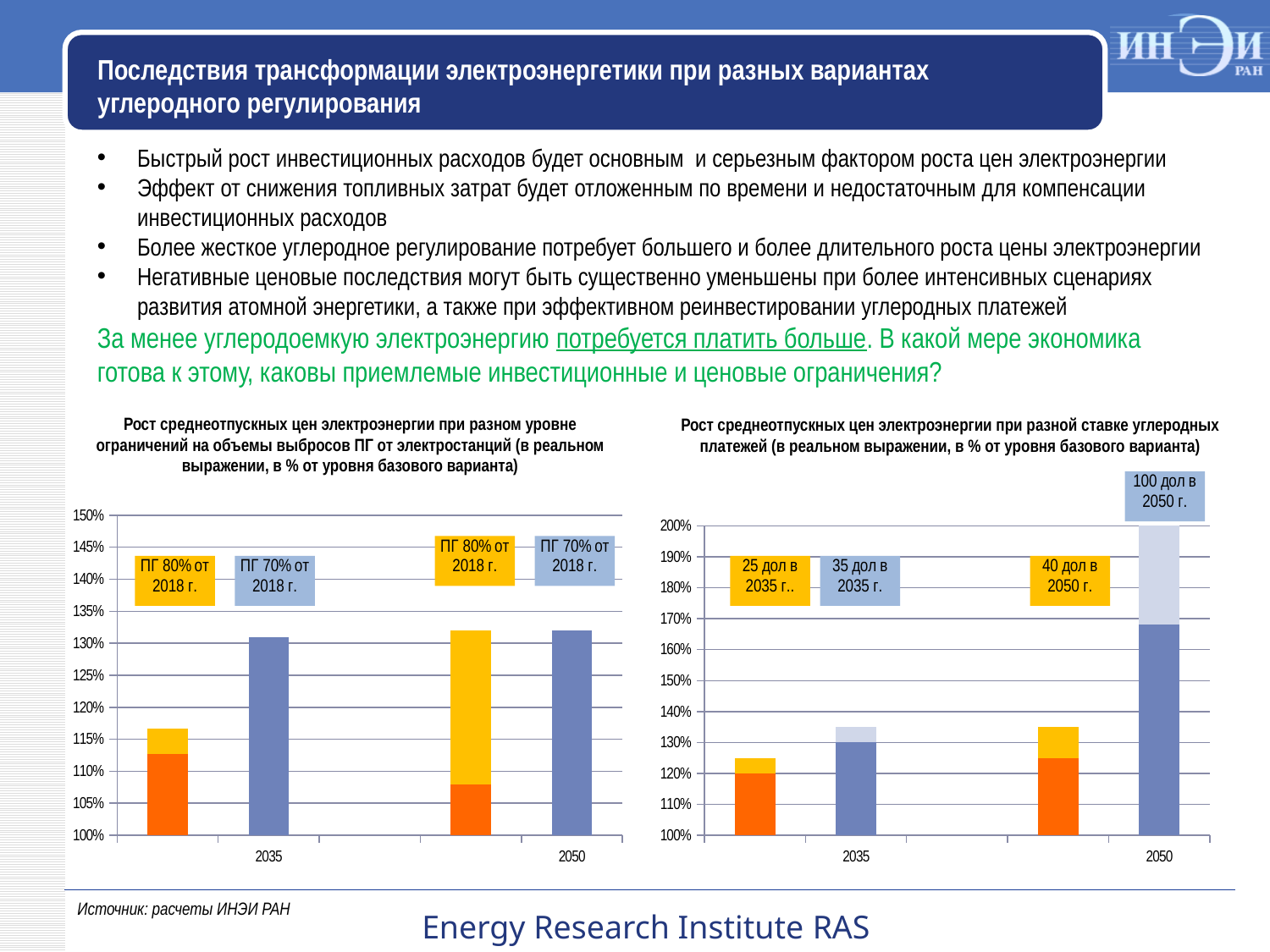
In the left chart, which bar is higher in 2035: 'ПГ 80% от 2018 г.' or 'ПГ 70% от 2018 г.'? ПГ 70% от 2018 г. In the right chart, is the value for the '25 дол в 2035 г.' bar greater or less than 130%? less What is the lowest value shown on the y axis of the left chart? 100% In the left chart, does the 'ПГ 80% от 2018 г.' bar rise or fall from 2035 to 2050? rise In the right chart, is the value for the '40 дол в 2050 г.' bar greater or less than 130%? greater What is the highest value shown on the y axis of the right chart? 200% What kind of chart is the left chart on the slide? bar chart How many years are shown on the x axis of the right chart? 2 In the right chart, which bar is higher in 2050: '40 дол в 2050 г.' or '100 дол в 2050 г.'? 100 дол в 2050 г. In the left chart, is the value for the 'ПГ 80% от 2018 г.' bar in 2035 greater or less than 120%? less